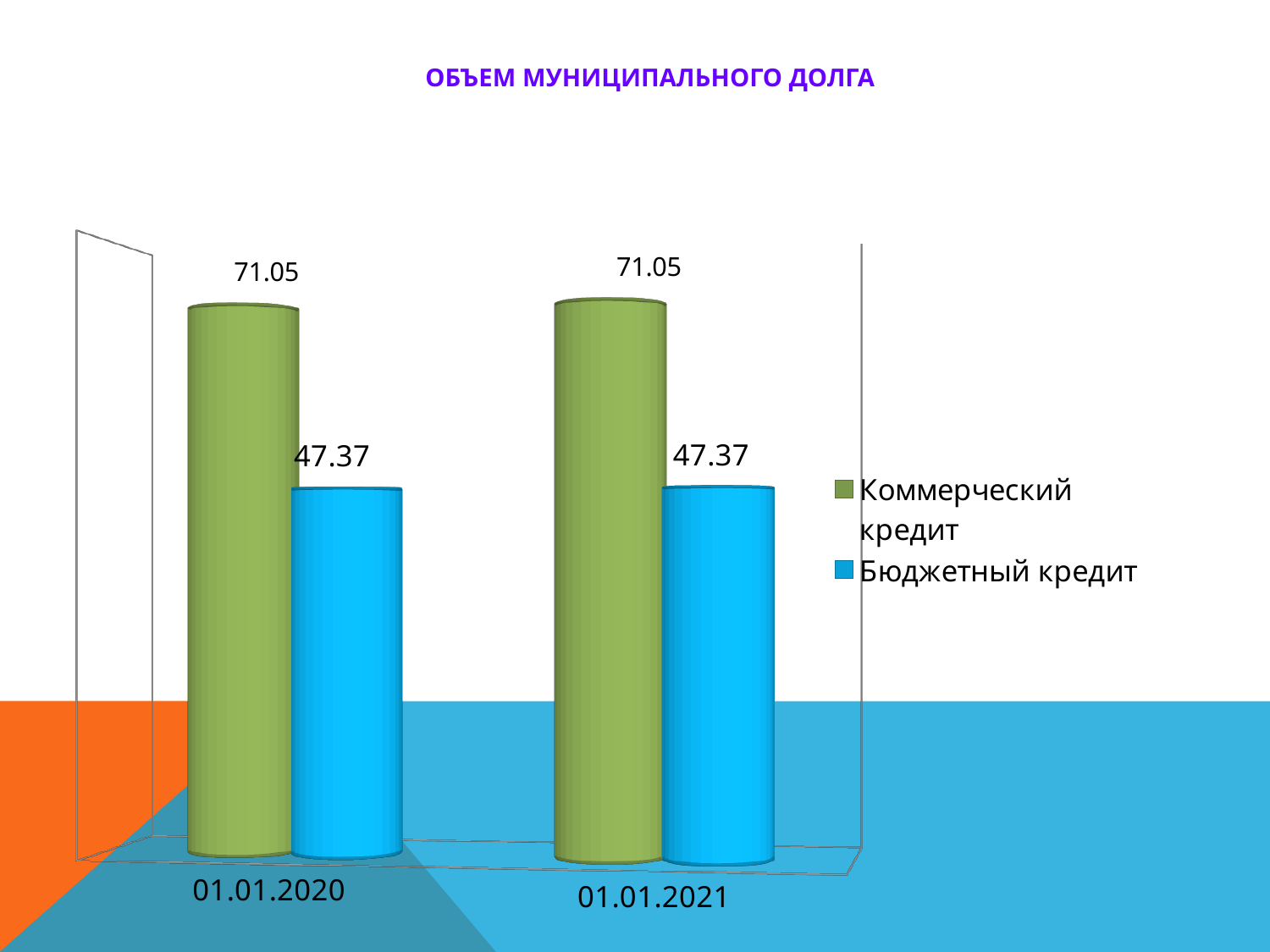
Which colour represents Бюджетный кредит in the legend? Blue What is the value of Бюджетный кредит on 01.01.2021? 47.37 What is the difference between Коммерческий кредит and Бюджетный кредит on 01.01.2021? 23.68 Does the value of Коммерческий кредит rise, fall or stay the same from 01.01.2020 to 01.01.2021? Stays the same What kind of chart is shown on the slide? Bar chart How many categories are shown on the x axis? 2 What is the title of the chart? ОБЪЕМ МУНИЦИПАЛЬНОГО ДОЛГА What is the value of Бюджетный кредит on 01.01.2020? 47.37 What is the value of Коммерческий кредит on 01.01.2021? 71.05 Which series has the higher value on 01.01.2020, Коммерческий кредит or Бюджетный кредит? Коммерческий кредит How many series does the legend list? 2 What is the value of Коммерческий кредит on 01.01.2020? 71.05